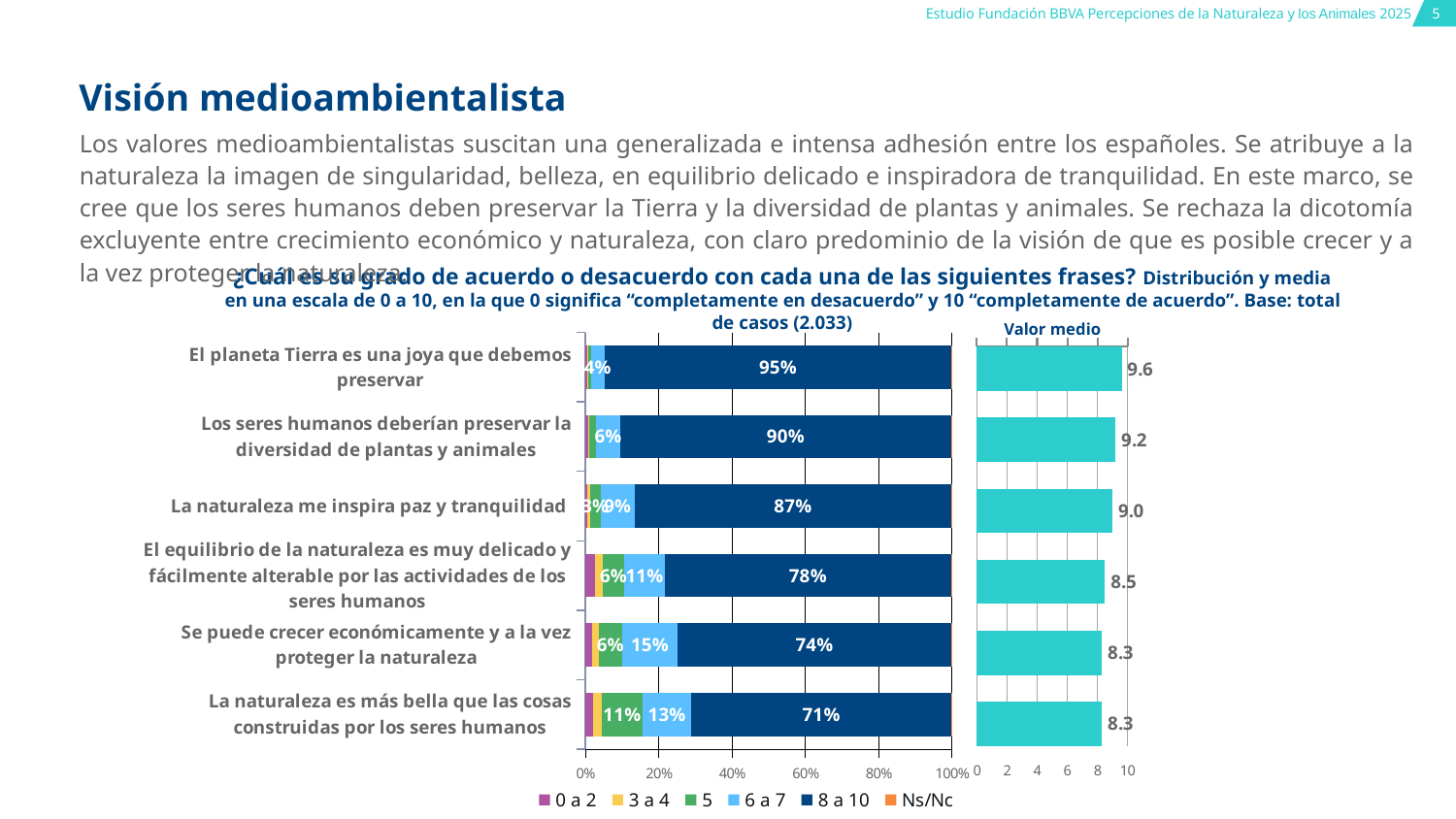
How many statements are shown in the stacked bar chart? 6 In the stacked bar chart, which statement has the lowest share of 8 a 10 responses? La naturaleza es más bella que las cosas construidas por los seres humanos In the stacked bar chart, which statement has the highest share of 8 a 10 responses? El planeta Tierra es una joya que debemos preservar What kind of chart is used to show the distribution of agreement scores? Stacked bar chart In the stacked bar chart, what percentage of respondents gave a score of 8 a 10 for "El planeta Tierra es una joya que debemos preservar"? 95% In the stacked bar chart, what percentage gave a score of 6 a 7 for "Se puede crecer económicamente y a la vez proteger la naturaleza"? 15% In the stacked bar chart legend, which colour represents the 8 a 10 category? Dark blue In the Valor medio chart, what is the mean value for "Los seres humanos deberían preservar la diversidad de plantas y animales"? 9.2 In the stacked bar chart, what is the difference in percentage points between the 8 a 10 share for "El planeta Tierra es una joya que debemos preservar" and for "La naturaleza es más bella que las cosas construidas por los seres humanos"? 24 percentage points In the Valor medio chart, what is the difference between the mean value for "El planeta Tierra es una joya que debemos preservar" and for "La naturaleza es más bella que las cosas construidas por los seres humanos"? 1.3 In the stacked bar chart, which statement has a larger 8 a 10 share: "Se puede crecer económicamente y a la vez proteger la naturaleza" or "El equilibrio de la naturaleza es muy delicado y fácilmente alterable por las actividades de los seres humanos"? El equilibrio de la naturaleza es muy delicado y fácilmente alterable por las actividades de los seres humanos How many series does the legend of the stacked bar chart list? 6